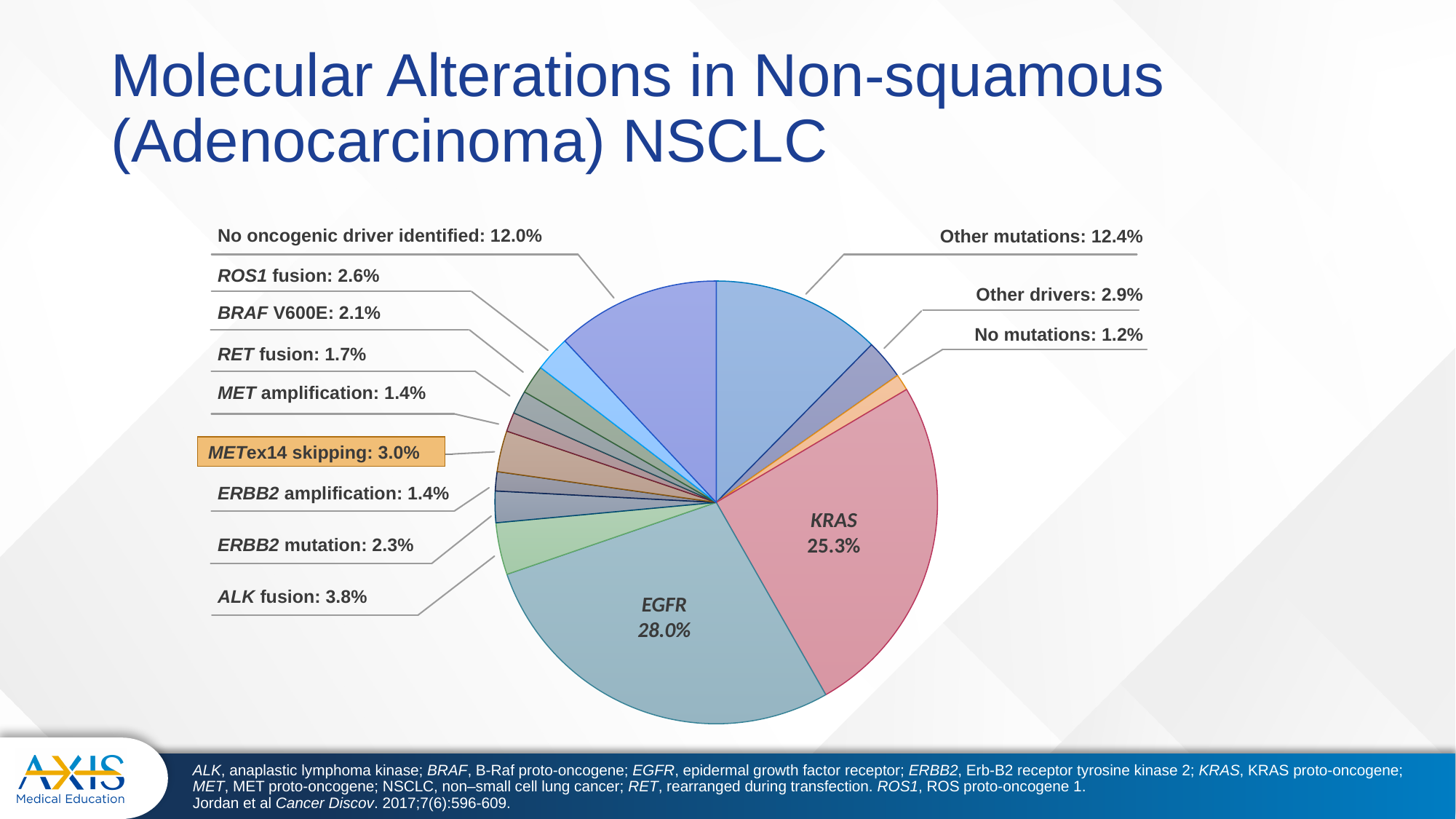
How many slices does the pie chart have? 14 What is the value for No oncogenic driver identified? 12.0% Which category has the largest share of the pie? EGFR Which label on the chart is highlighted with an orange box? METex14 skipping: 3.0% Which is larger, Other mutations or No oncogenic driver identified? Other mutations What is the value for METex14 skipping? 3.0% What type of chart is shown on the slide? pie chart What percentage is shown for KRAS? 25.3% What is the difference between the EGFR and KRAS percentages? 2.7% Which category has the smallest share of the pie? No mutations What percentage is labelled for ALK fusion? 3.8% What percentage of the pie is EGFR? 28.0%